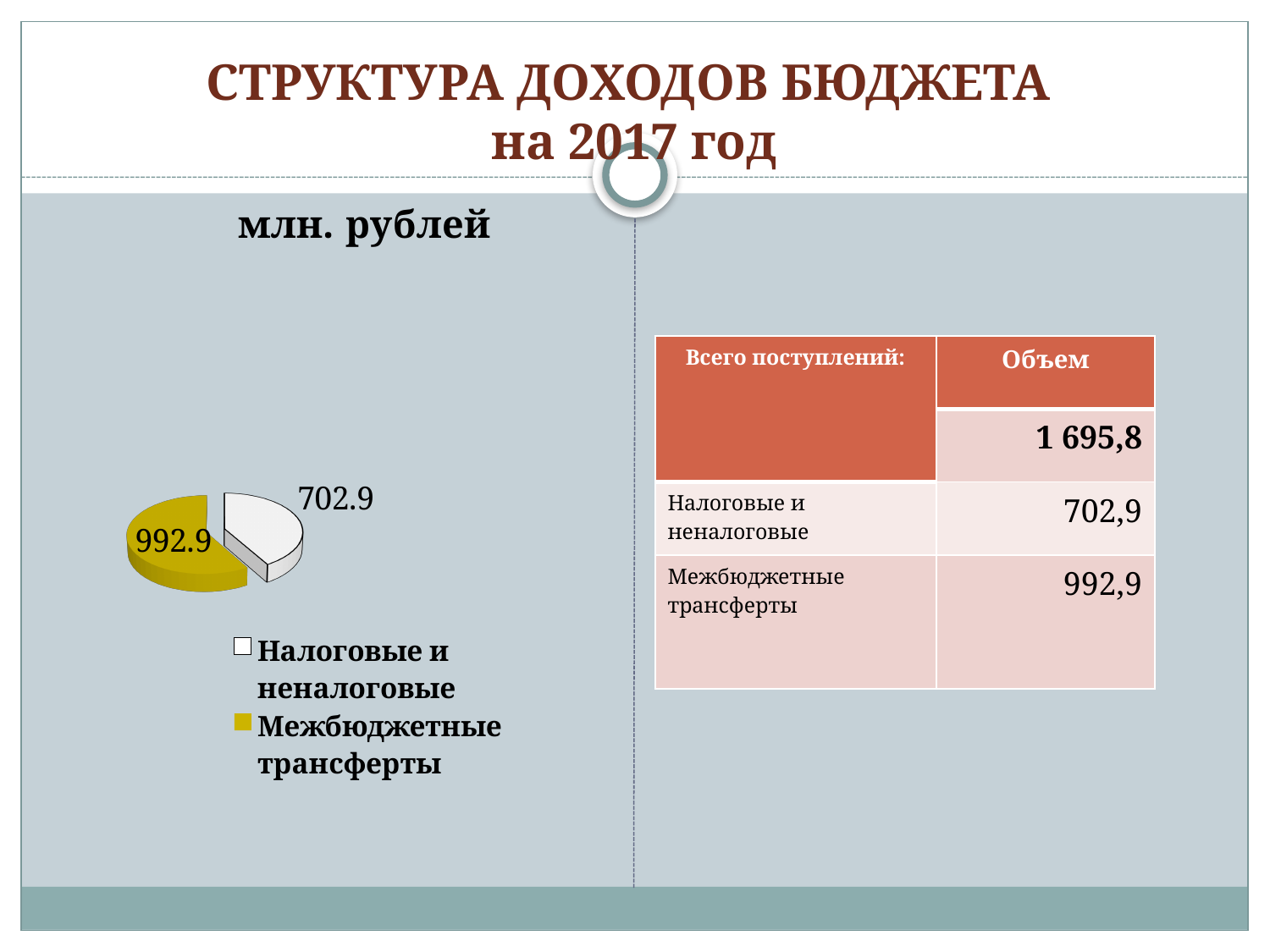
What colour is the Межбюджетные трансферты slice in the pie chart? Yellow How many slices does the pie chart have? 2 What is the value shown for the Межбюджетные трансферты slice of the pie chart? 992.9 What is the total of the two values shown in the pie chart? 1695.8 What share of the pie chart does the Межбюджетные трансферты slice represent? 58.6% Which category has the smallest slice in the pie chart? Налоговые и неналоговые What type of chart is shown on the slide? Pie chart Which category has the largest slice in the pie chart? Межбюджетные трансферты What is the value shown for the Налоговые и неналоговые slice of the pie chart? 702.9 By how much does the Межбюджетные трансферты value exceed the Налоговые и неналоговые value in the pie chart? 290 How many entries does the pie chart's legend list? 2 Which is larger in the pie chart: Налоговые и неналоговые or Межбюджетные трансферты? Межбюджетные трансферты